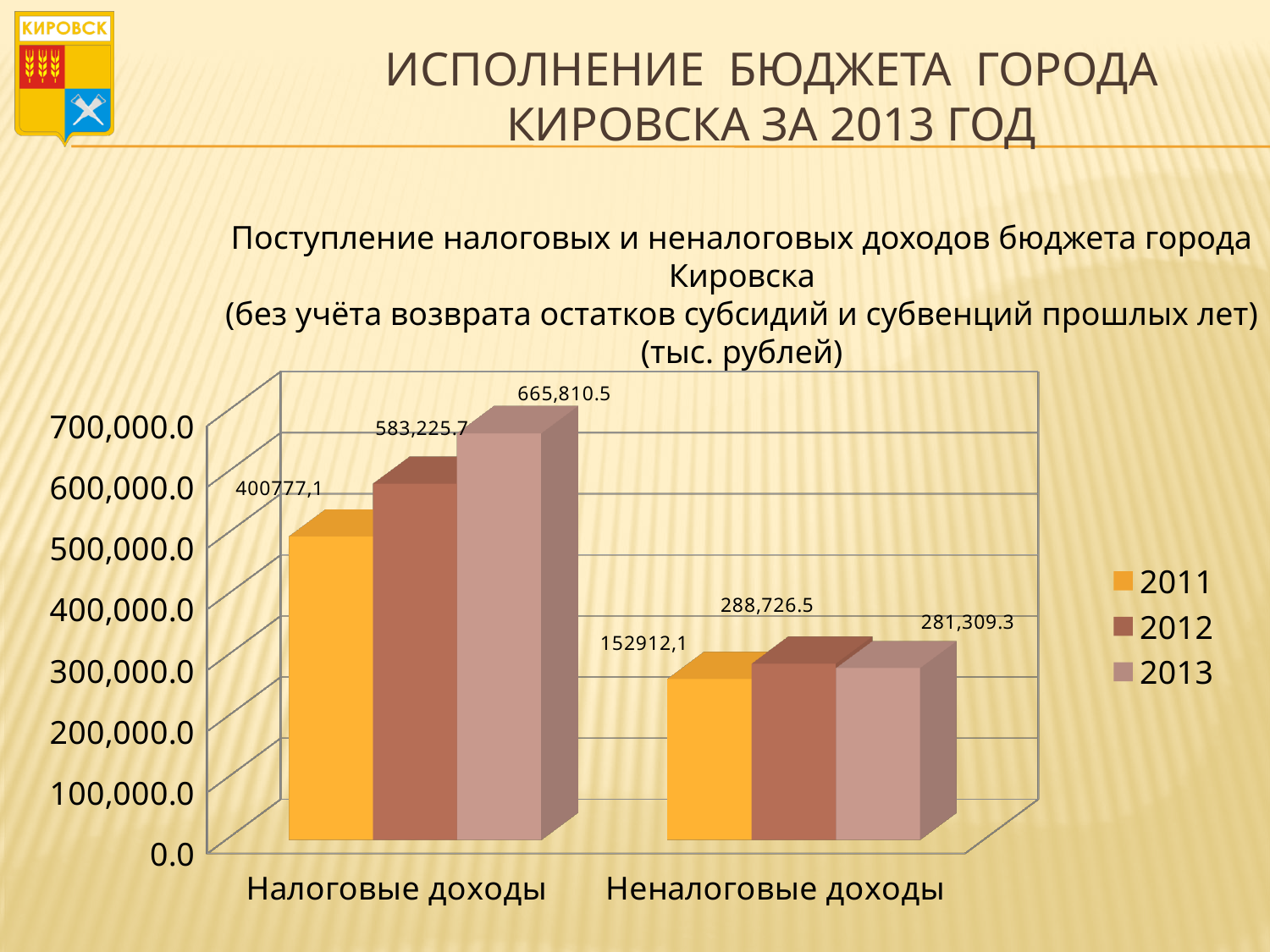
Which year has the lowest value for Неналоговые доходы? 2011 What is the value for 2013 in the Налоговые доходы category? 665,810.5 Which year has the highest value for Налоговые доходы? 2013 What is the value for 2011 in the Налоговые доходы category? 400777,1 How many series does the legend list? 3 What is the value for 2012 in the Неналоговые доходы category? 288,726.5 How many categories are shown on the x axis? 2 What is the difference between the 2013 and 2012 values for Налоговые доходы? 82,584.8 What kind of chart is shown on the slide? Bar chart What is the value for 2013 in the Неналоговые доходы category? 281,309.3 Which is larger for Неналоговые доходы: the 2012 value or the 2013 value? 2012